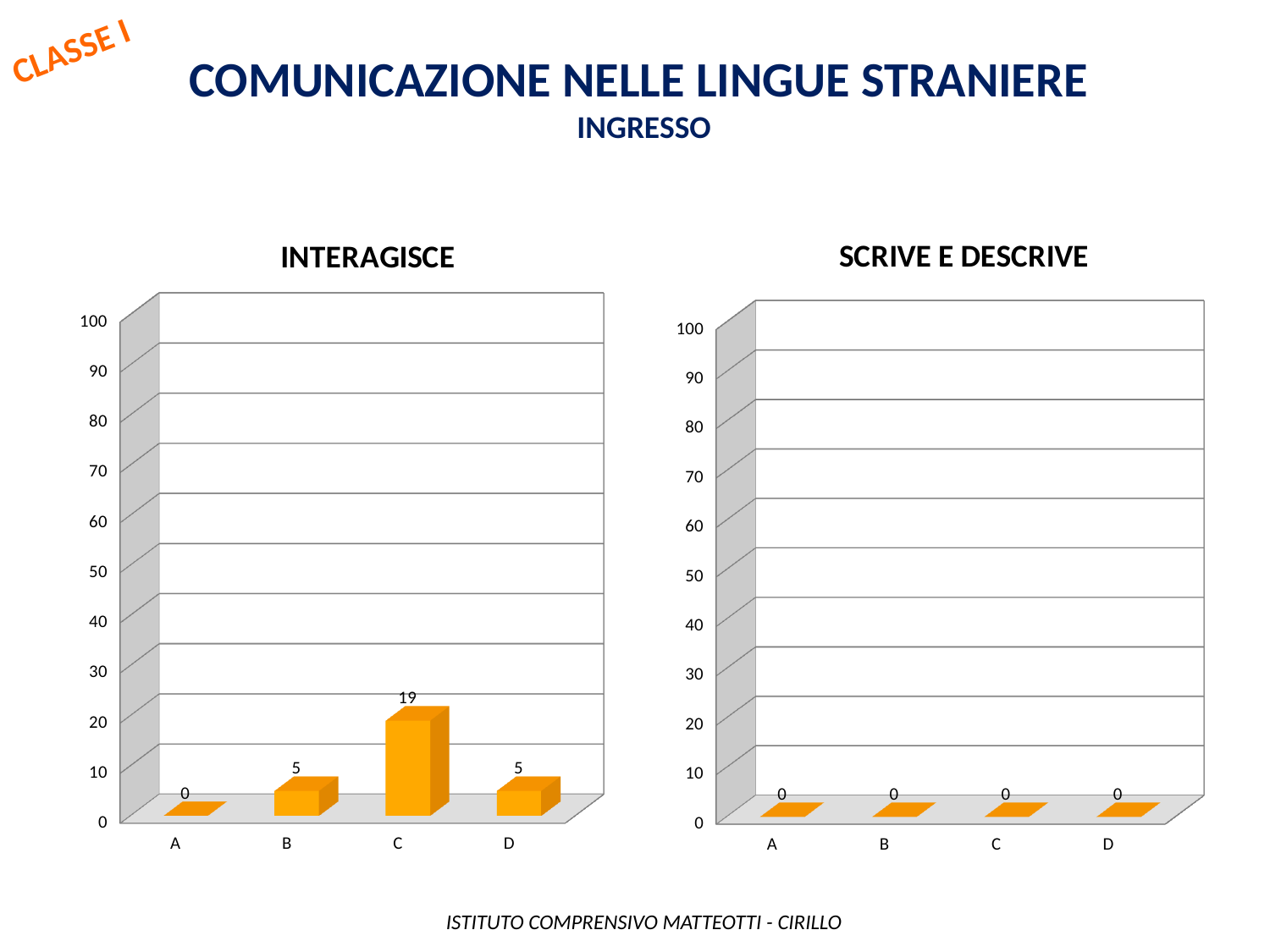
In the INTERAGISCE chart, is the value for C greater or less than 10? greater In the SCRIVE E DESCRIVE chart, what is the value for category C? 0 What kind of chart is the INTERAGISCE chart? bar chart In the INTERAGISCE chart, what is the value for category A? 0 In the INTERAGISCE chart, which category has the highest value? C In the INTERAGISCE chart, which category has the lowest value? A In the INTERAGISCE chart, what is the value for category C? 19 What is the title of the chart on the right side of the slide? SCRIVE E DESCRIVE How many categories are shown in the SCRIVE E DESCRIVE chart? 4 Which chart has a larger value for category C, INTERAGISCE or SCRIVE E DESCRIVE? INTERAGISCE In the INTERAGISCE chart, what is the difference between the values for C and D? 14 In the INTERAGISCE chart, what is the value for category B? 5